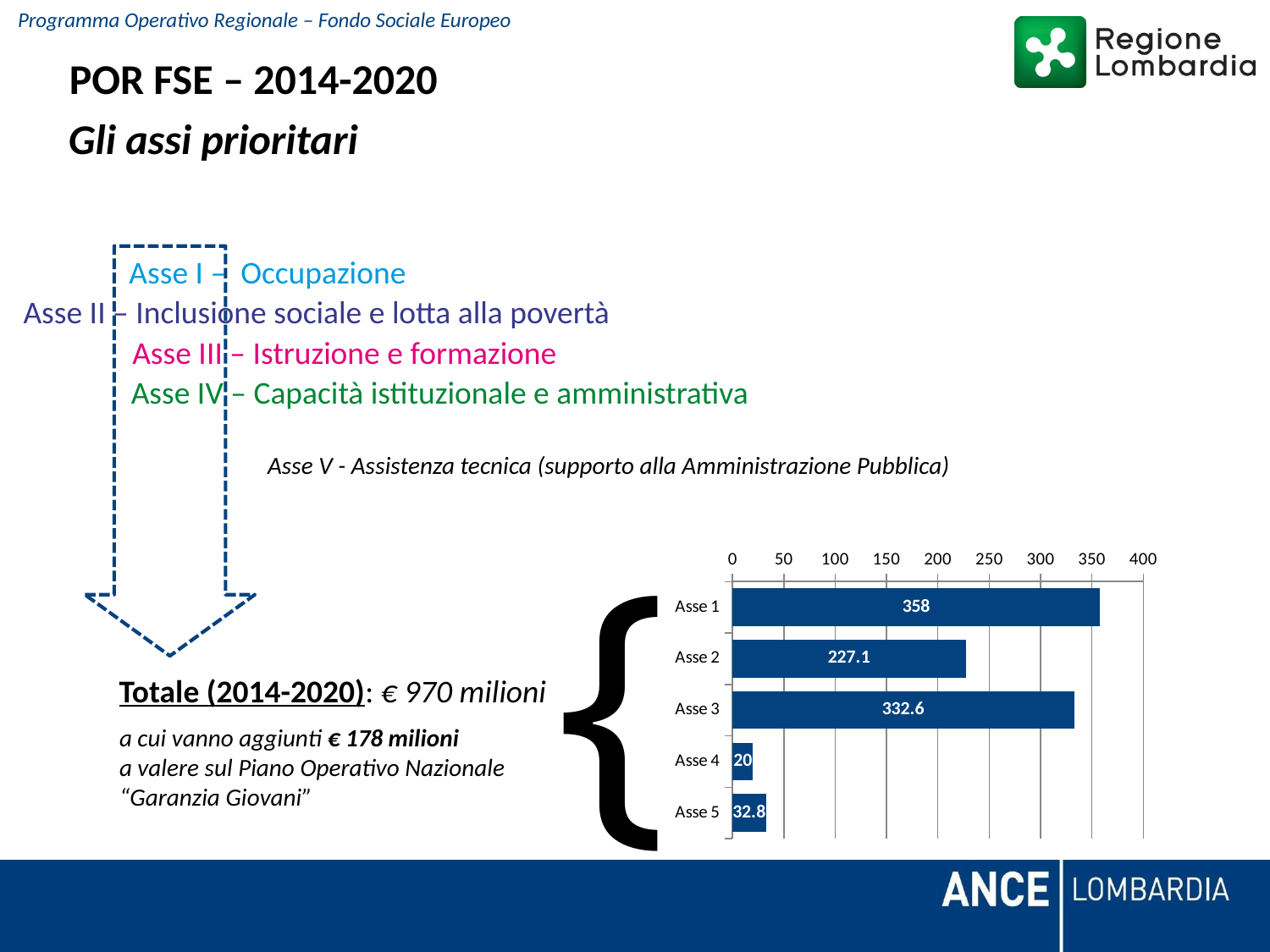
What is the value for Asse 2? 227.1 How many categories are shown in the chart? 5 What kind of chart is shown on the slide? bar chart Which category has the lowest value? Asse 4 What is the difference between the values for Asse 1 and Asse 3? 25.4 What is the value for Asse 1? 358 Is the value for Asse 2 greater or less than 200? greater What is the value for Asse 5? 32.8 What is the value for Asse 3? 332.6 What is the difference between the values for Asse 5 and Asse 4? 12.8 Which is larger, the value for Asse 2 or the value for Asse 3? Asse 3 Which category has the highest value? Asse 1